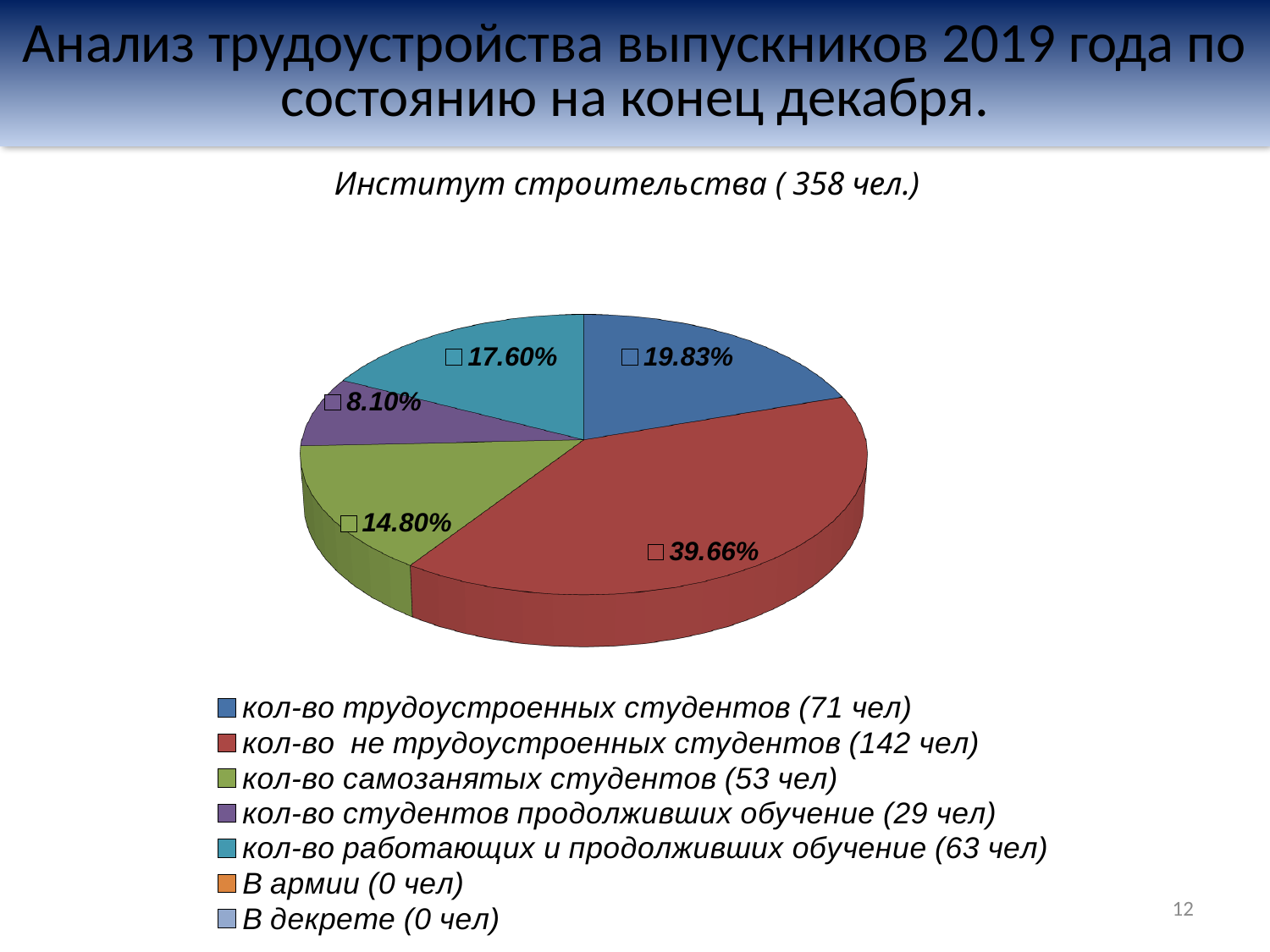
What percentage of the pie is labelled for the slice 'кол-во не трудоустроенных студентов'? 39.66% What percentage is shown for the slice 'кол-во трудоустроенных студентов'? 19.83% What percentage is shown for the slice 'кол-во работающих и продолживших обучение'? 17.60% What is the difference in percentage points between the 'не трудоустроенных' slice and the 'трудоустроенных' slice? 19.83 What percentage is shown for the slice 'кол-во самозанятых студентов'? 14.80% How many entries does the legend list? 7 What type of chart is shown on the slide? pie chart What percentage is shown for the slice 'кол-во студентов продолживших обучение'? 8.10% Which category has the largest share of the pie? кол-во не трудоустроенных студентов Among the slices with a non-zero share, which category has the smallest share? кол-во студентов продолживших обучение What is the title of the chart? Институт строительства ( 358 чел.) Which slice is larger: 'кол-во работающих и продолживших обучение' or 'кол-во самозанятых студентов'? кол-во работающих и продолживших обучение